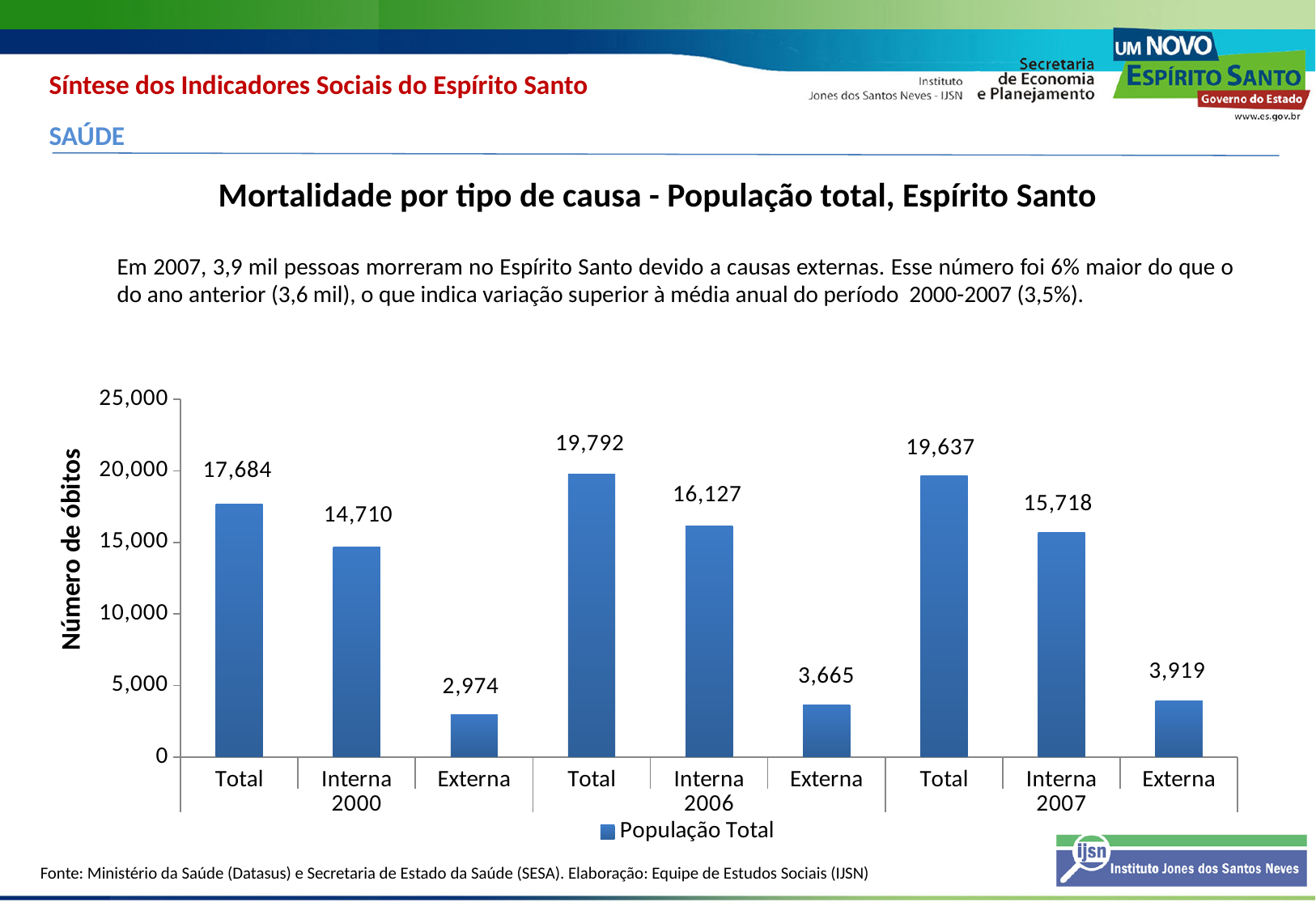
What kind of chart is shown? bar chart What is the difference between Total 2007 and Interna 2007? 3,919 Is the value for Total 2007 greater or less than 20,000? less Which bar has the highest value? Total 2006 What is the value for Externa in 2007? 3,919 What is the difference between Externa 2007 and Externa 2006? 254 How many bars are plotted in the chart? 9 Which bar has the lowest value? Externa 2000 Which is larger, Interna 2000 or Interna 2007? Interna 2007 What is the value for Total in 2000? 17,684 What is the y-axis title of the chart? Número de óbitos What is the value for Interna in 2006? 16,127